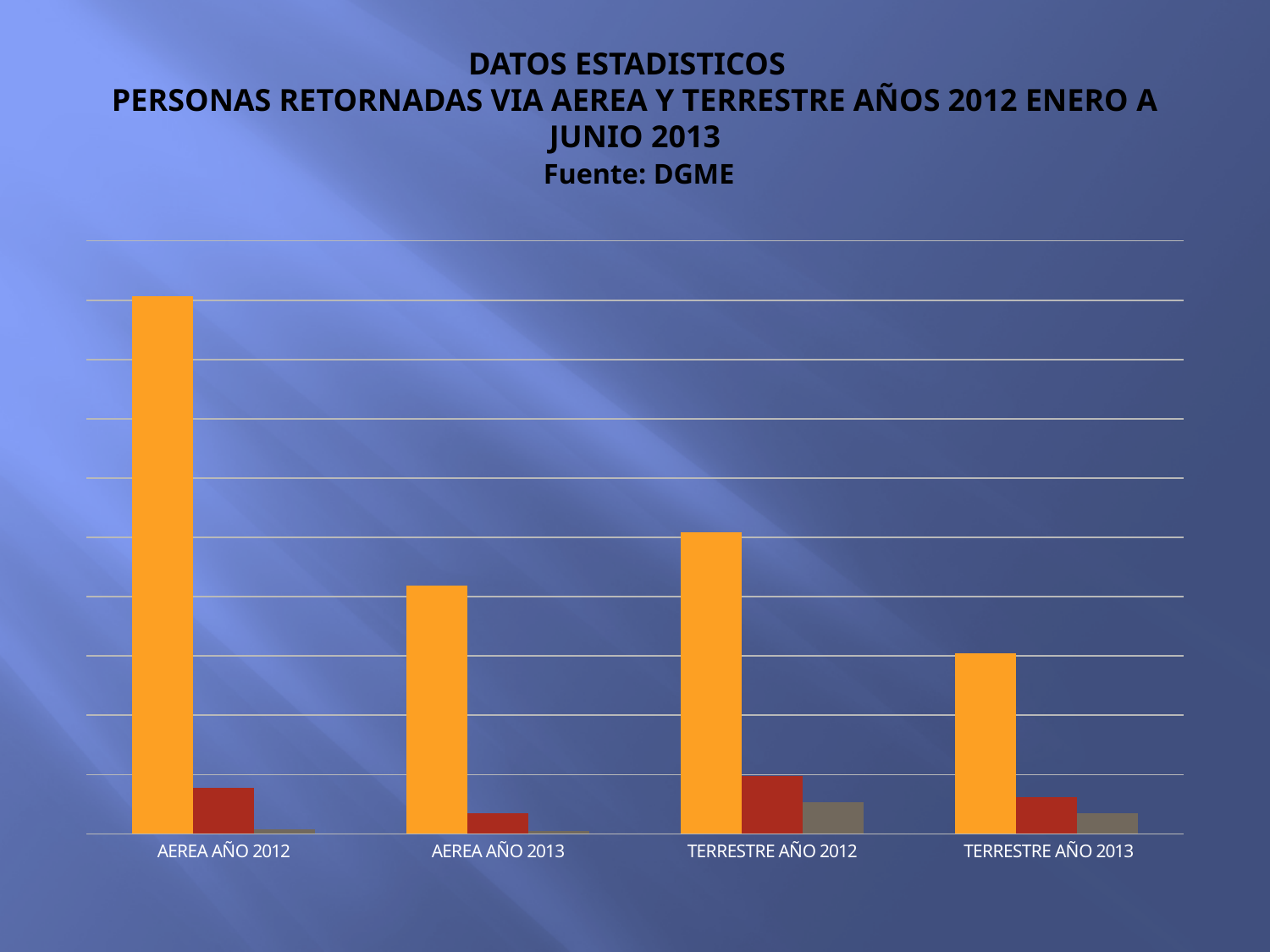
How many bars are plotted for each category in the chart? 3 Which category has the tallest red bar? TERRESTRE AÑO 2012 Which colour of bar is the tallest in every category of the chart? Orange Which category has the shortest orange bar? TERRESTRE AÑO 2013 According to the slide title, what is the source (fuente) of the data? DGME Which category has the tallest orange bar? AEREA AÑO 2012 How many categories are shown along the x axis of the chart? 4 What kind of chart is shown on the slide? Bar chart Is the orange bar for AEREA AÑO 2012 taller or shorter than the orange bar for TERRESTRE AÑO 2012? Taller Is the orange bar for AEREA AÑO 2013 taller or shorter than the orange bar for TERRESTRE AÑO 2013? Taller Is the red bar for AEREA AÑO 2012 taller or shorter than the red bar for AEREA AÑO 2013? Taller Which category has the tallest gray bar? TERRESTRE AÑO 2012